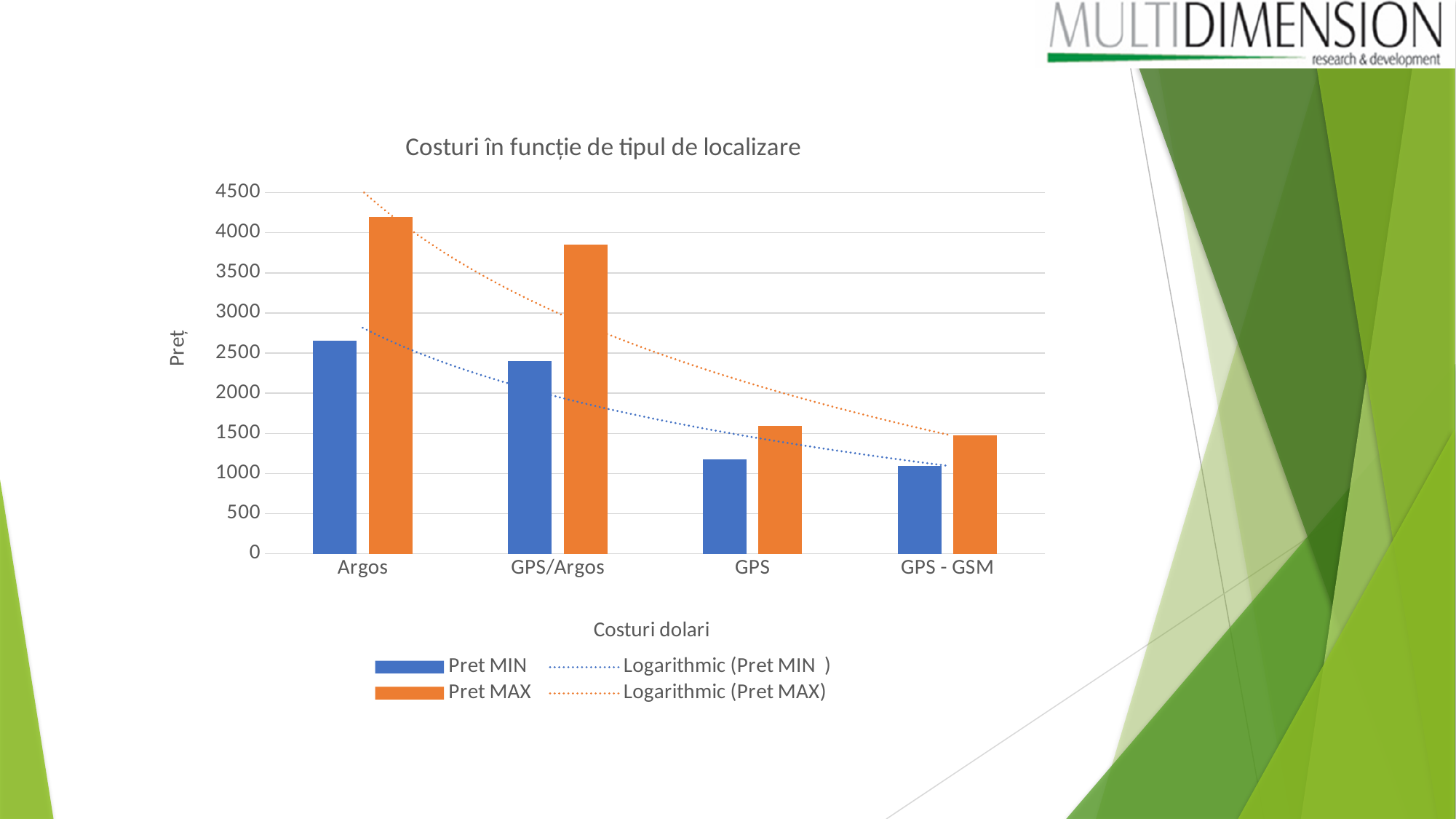
Is the Pret MAX value for GPS greater or less than 1500? greater How many categories are shown on the x axis of the chart? 4 Is the Pret MAX value for GPS/Argos greater or less than 4000? less Is the Pret MIN value for GPS/Argos greater or less than 2500? less How many entries does the chart's legend list? 4 What is the title of the chart? Costuri în funcție de tipul de localizare Which category has the highest Pret MAX value? Argos What type of chart is shown on the slide? bar chart Which category has the highest Pret MIN value? Argos Do the Pret MIN values rise or fall moving from Argos to GPS - GSM along the x axis? fall Which is larger, the Pret MAX value for Argos or the Pret MAX value for GPS/Argos? Argos